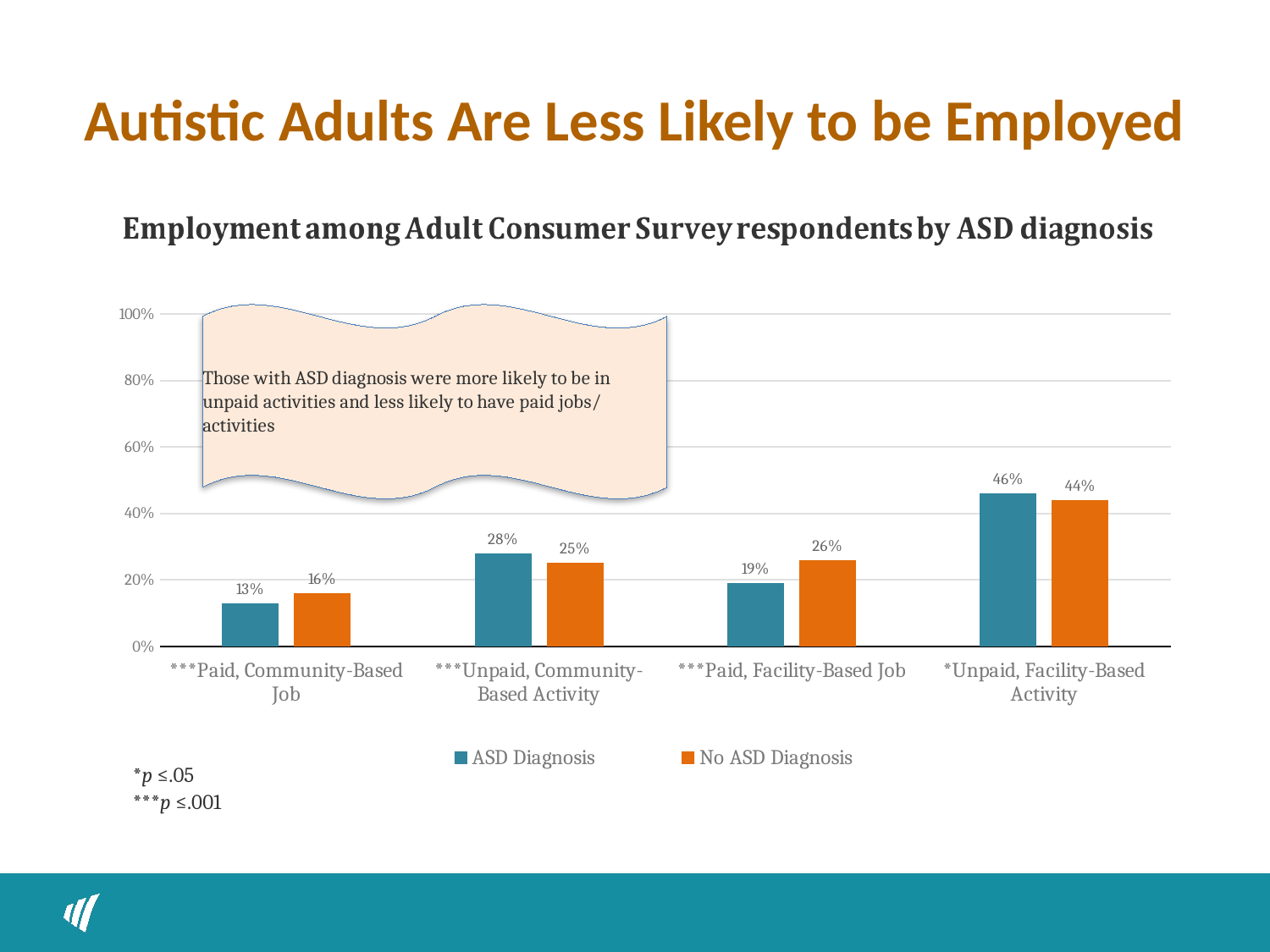
How many series does the legend list? 2 In the Unpaid, Community-Based Activity category, which series has the larger value, ASD Diagnosis or No ASD Diagnosis? ASD Diagnosis What kind of chart is shown on the slide? bar chart What is the value for ASD Diagnosis in the Unpaid, Facility-Based Activity category? 46% How many categories are shown on the x axis of the chart? 4 What is the difference between the No ASD Diagnosis and ASD Diagnosis values in the Paid, Facility-Based Job category? 7% Which category has the lowest value for the ASD Diagnosis series? Paid, Community-Based Job Which category has the highest value for the No ASD Diagnosis series? Unpaid, Facility-Based Activity What is the title of the chart? Employment among Adult Consumer Survey respondents by ASD diagnosis What is the value for ASD Diagnosis in the Paid, Community-Based Job category? 13% Is the value for No ASD Diagnosis in the Unpaid, Facility-Based Activity category greater or less than 40%? greater What is the value for No ASD Diagnosis in the Paid, Facility-Based Job category? 26%